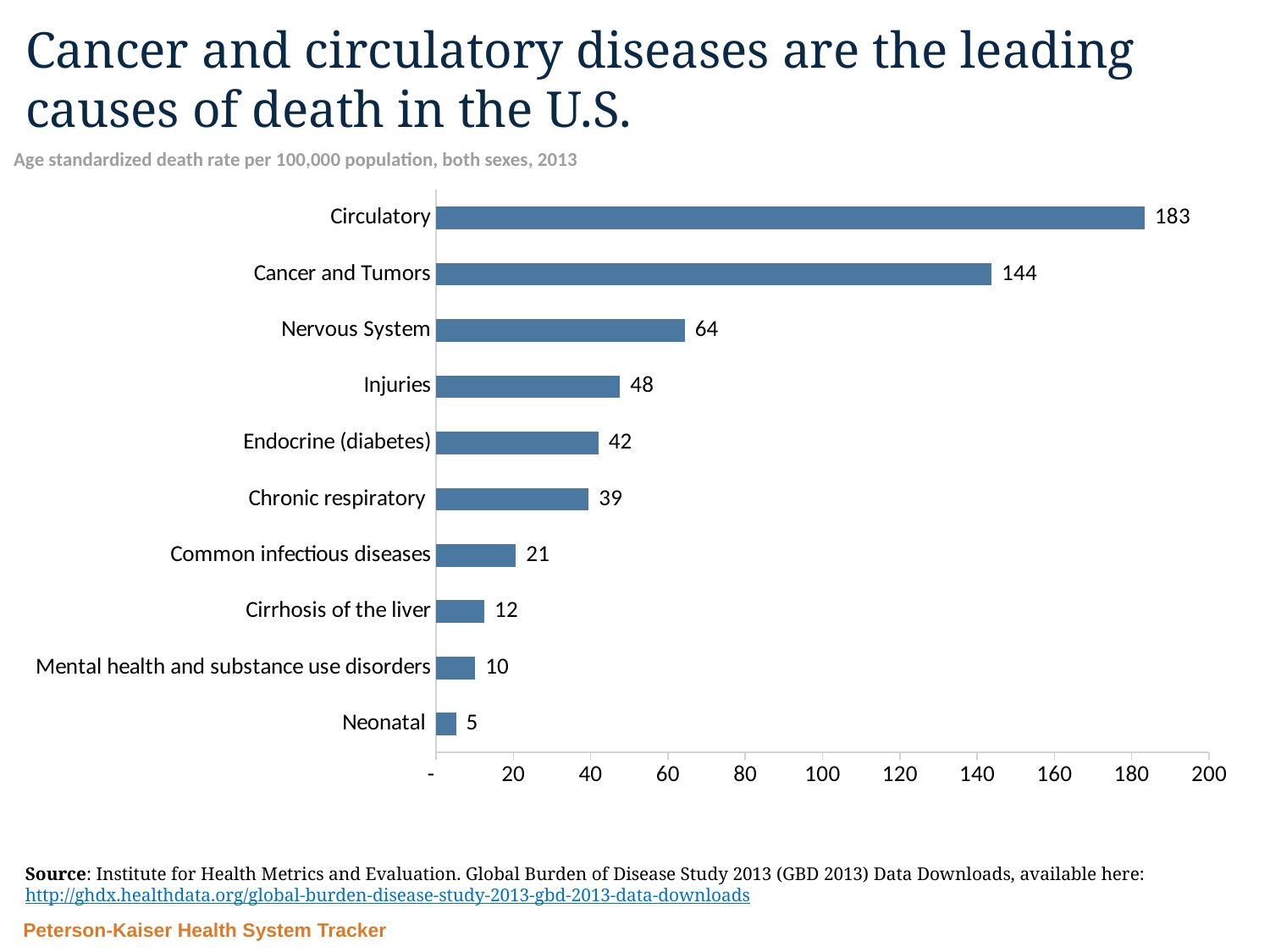
What type of chart is shown on the slide? Bar chart Which cause of death has the lowest death rate? Neonatal What is the value for Common infectious diseases? 21 Is the value for Cancer and Tumors greater or less than 140? greater What is the difference between the values for Injuries and Endocrine (diabetes)? 6 Which cause of death has the highest death rate? Circulatory Which has a higher death rate, Chronic respiratory or Cirrhosis of the liver? Chronic respiratory How many causes of death are shown in the chart? 10 What is the subtitle describing the measure plotted in the chart? Age standardized death rate per 100,000 population, both sexes, 2013 What is the death rate shown for Nervous System? 64 What is the difference between the death rates for Circulatory and Cancer and Tumors? 39 What is the age standardized death rate for Circulatory diseases? 183